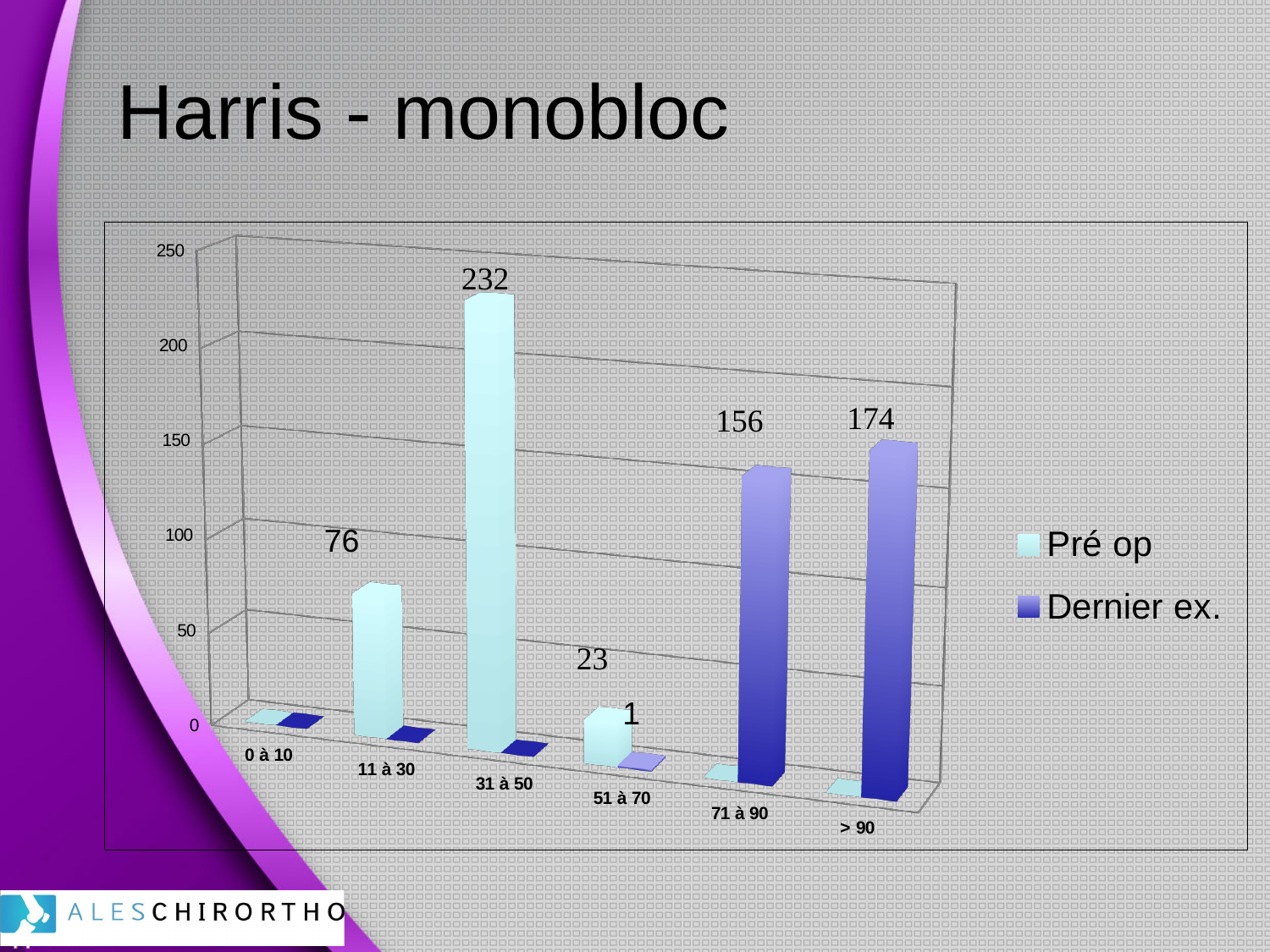
What is the Dernier ex. value for the 71 à 90 category? 156 What is the Dernier ex. value for the > 90 category? 174 What type of chart is shown on the slide? Bar chart How many series does the legend list? 2 What is the Dernier ex. value for the 51 à 70 category? 1 What is the difference between the Dernier ex. values for > 90 and 71 à 90? 18 How many categories are shown on the x axis? 6 Which category has the highest Pré op value? 31 à 50 Which is larger: the Pré op value for 11 à 30 or the Pré op value for 51 à 70? 11 à 30 Which category has the highest Dernier ex. value? > 90 What is the Pré op value for the 31 à 50 category? 232 What is the Pré op value for the 11 à 30 category? 76